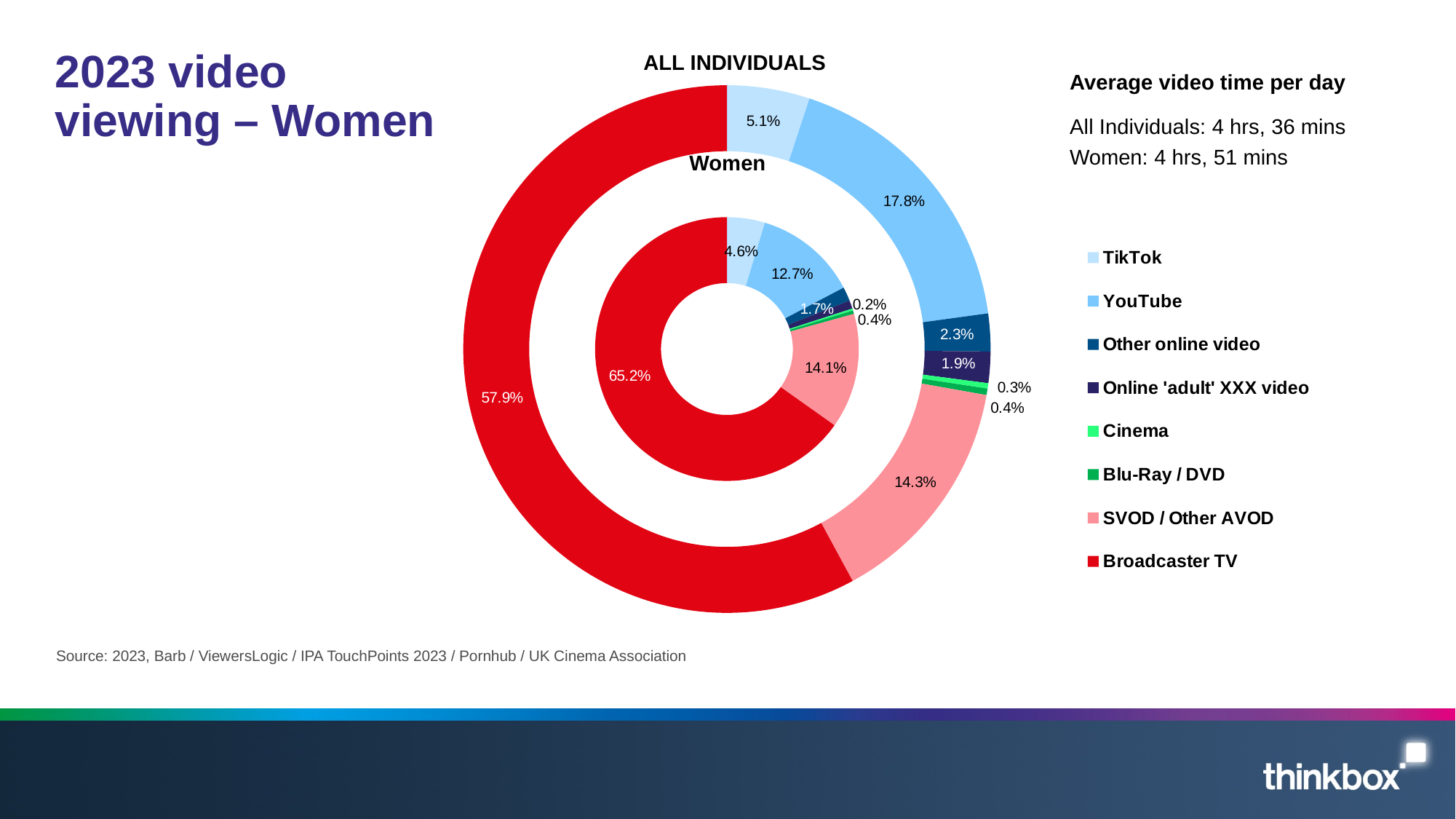
How much higher is the Broadcaster TV share for Women than for All Individuals? 7.3 percentage points What share of video viewing does Broadcaster TV account for among All Individuals? 57.9% How many categories does the legend list? 8 Which category has the largest share in the Women ring? Broadcaster TV What is the YouTube share for All Individuals? 17.8% According to the slide, what is the average video time per day for Women? 4 hrs, 51 mins What is the YouTube share for Women? 12.7% What is the SVOD / Other AVOD share for All Individuals? 14.3% What kind of chart is shown on the slide? Doughnut chart What share of video viewing does Broadcaster TV account for among Women? 65.2% Is the YouTube share larger for All Individuals or for Women? All Individuals What is the TikTok share for Women? 4.6%